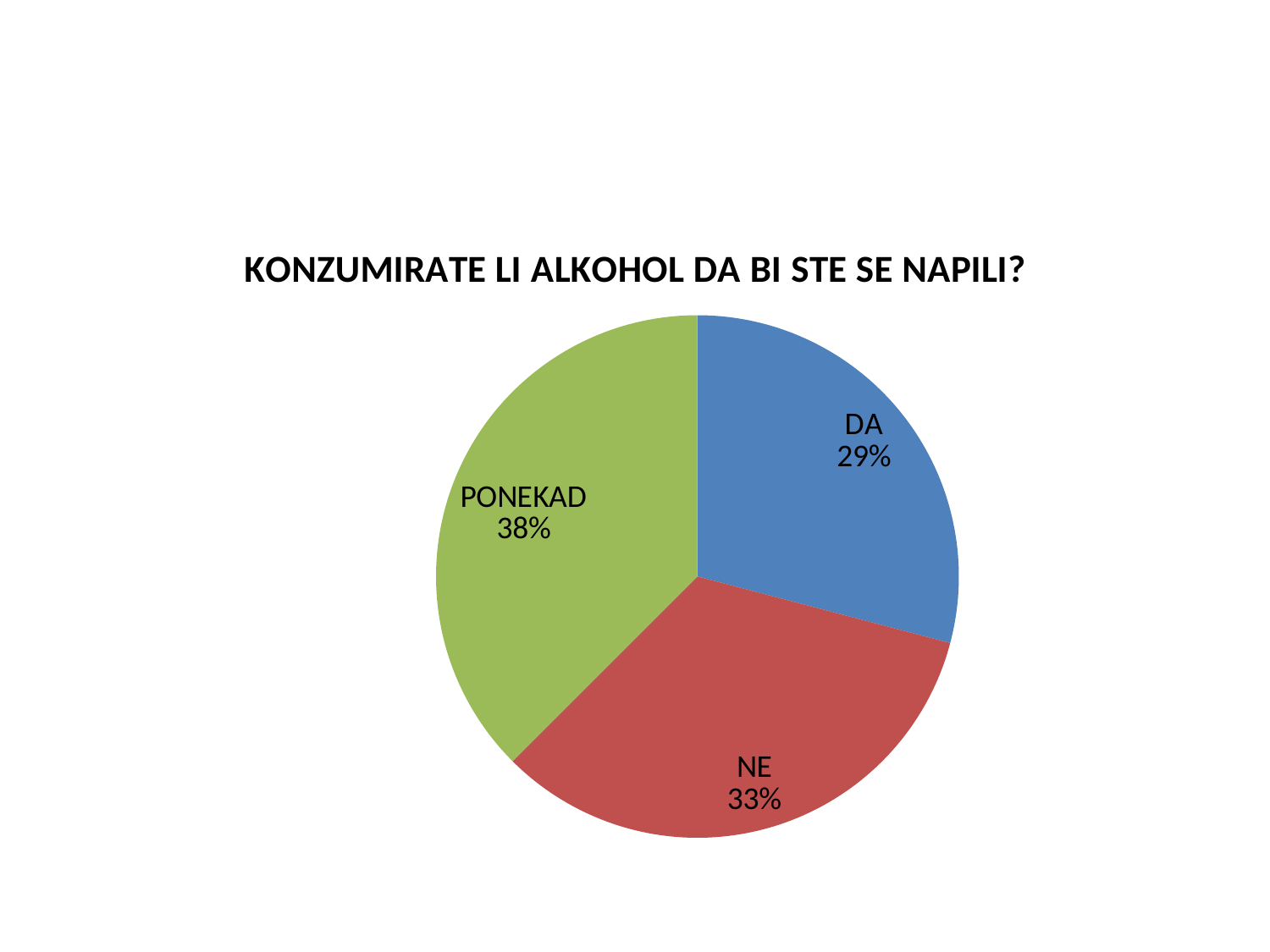
What is the difference in percentage points between the NE slice and the DA slice? 4 What type of chart is shown on the slide? pie chart Which is larger, the NE slice or the DA slice? NE Which slice of the pie is the smallest? DA Which slice of the pie is the largest? PONEKAD How many slices does the pie chart have? 3 What is the title of the chart? KONZUMIRATE LI ALKOHOL DA BI STE SE NAPILI? What percentage of the pie is the DA slice? 29% What percentage of the pie is the PONEKAD slice? 38% What is the difference in percentage points between the PONEKAD slice and the DA slice? 9 What percentage of the pie is the NE slice? 33% What colour is the PONEKAD slice? green